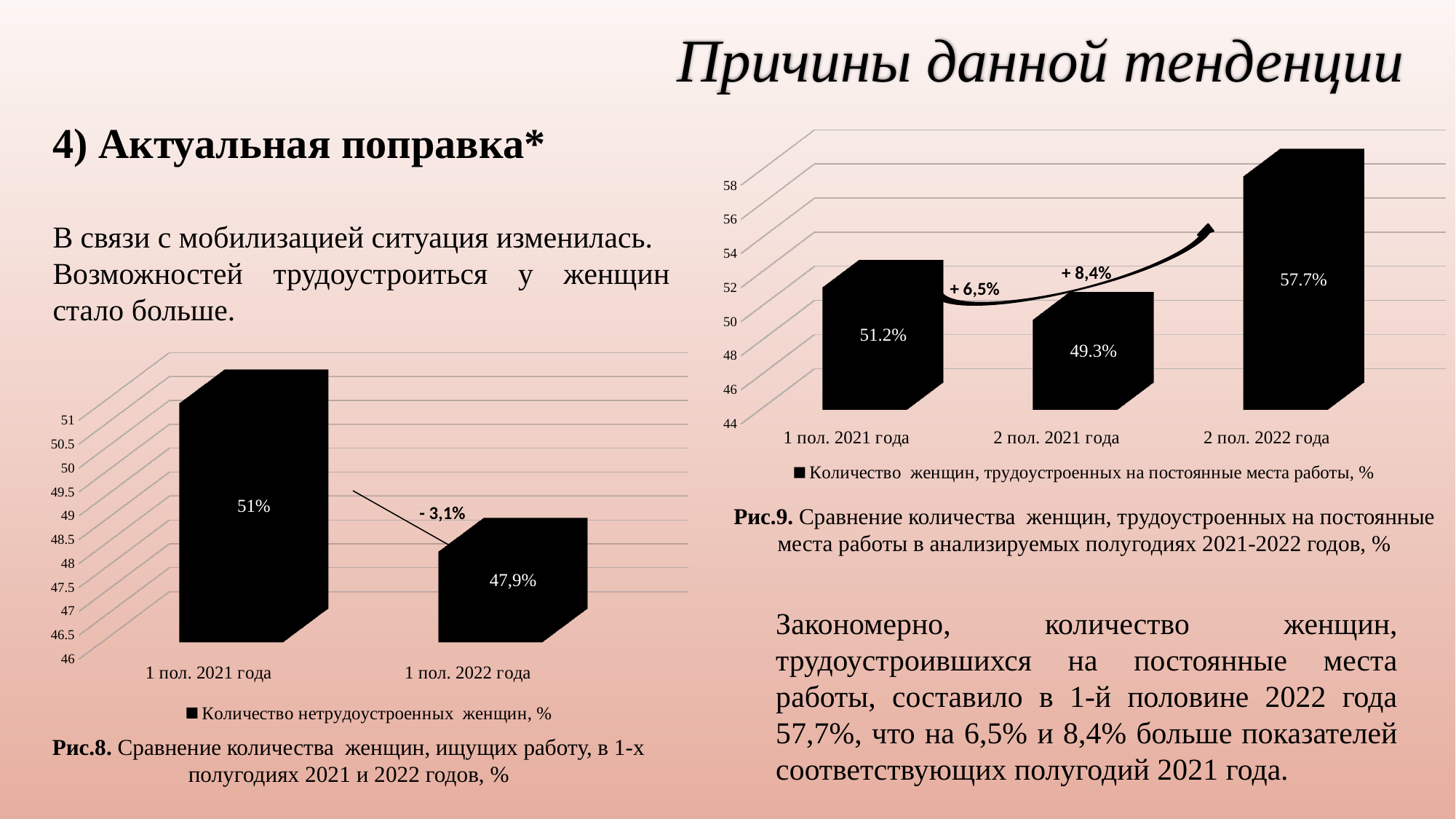
In the right chart (Рис.9), what is the difference between the values for 2 пол. 2022 года and 1 пол. 2021 года? 6.5% In the right chart (Рис.9), which category has the highest value? 2 пол. 2022 года In the left chart (Рис.8), how many bars are plotted? 2 In the left chart (Рис.8), what is the value for 1 пол. 2021 года? 51% In the right chart (Рис.9), what is the value for 2 пол. 2021 года? 49.3% In the left chart (Рис.8), what kind of chart is shown? Bar chart In the right chart (Рис.9), what is the value for 2 пол. 2022 года? 57.7% In the left chart (Рис.8), what is the difference between the values for 1 пол. 2021 года and 1 пол. 2022 года? 3,1% In the left chart (Рис.8), what is the value for 1 пол. 2022 года? 47,9% In the right chart (Рис.9), which category has the lowest value? 2 пол. 2021 года In the right chart (Рис.9), what series name does the legend show? Количество женщин, трудоустроенных на постоянные места работы, % In the right chart (Рис.9), is the value for 2 пол. 2022 года greater or less than 56? greater